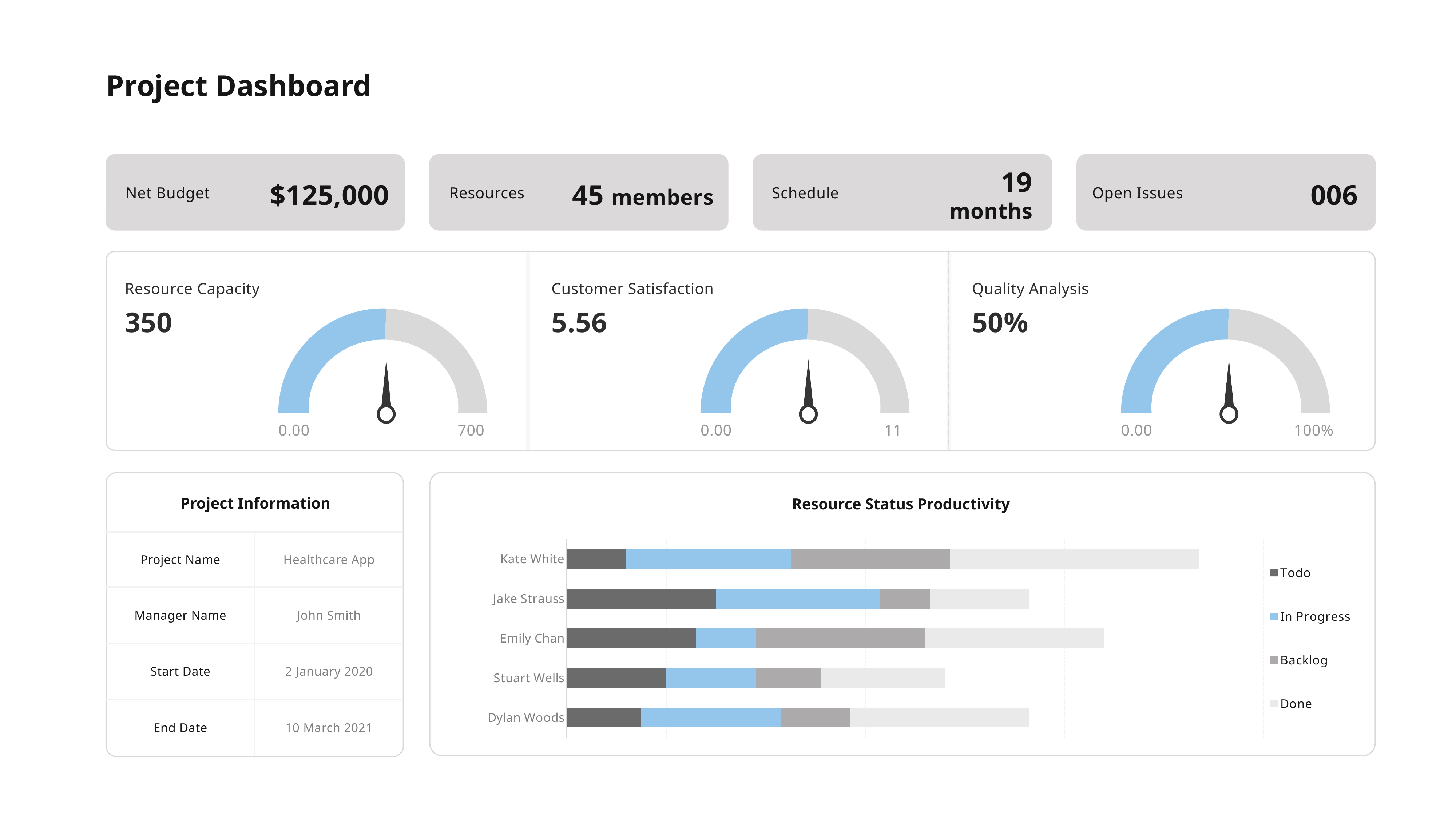
How many people are listed on the Resource Status Productivity chart? 5 On the Resource Status Productivity chart, which person has the longest total bar? Kate White On the Resource Status Productivity chart, is the Todo segment larger for Emily Chan or Stuart Wells? Emily Chan On the Resource Status Productivity chart, which person has the shortest In Progress segment? Emily Chan On the Customer Satisfaction gauge, what value is shown? 5.56 On the Resource Capacity gauge, what value is shown? 350 On the Resource Capacity gauge, what is the maximum value printed at the end of the scale? 700 On the Customer Satisfaction gauge, what is the maximum value printed at the end of the scale? 11 On the Quality Analysis gauge, what value is shown? 50% How many series does the legend of the Resource Status Productivity chart list? 4 What kind of chart is the Resource Status Productivity chart? Stacked bar chart On the Resource Status Productivity chart, which person has the longest Todo segment? Jake Strauss